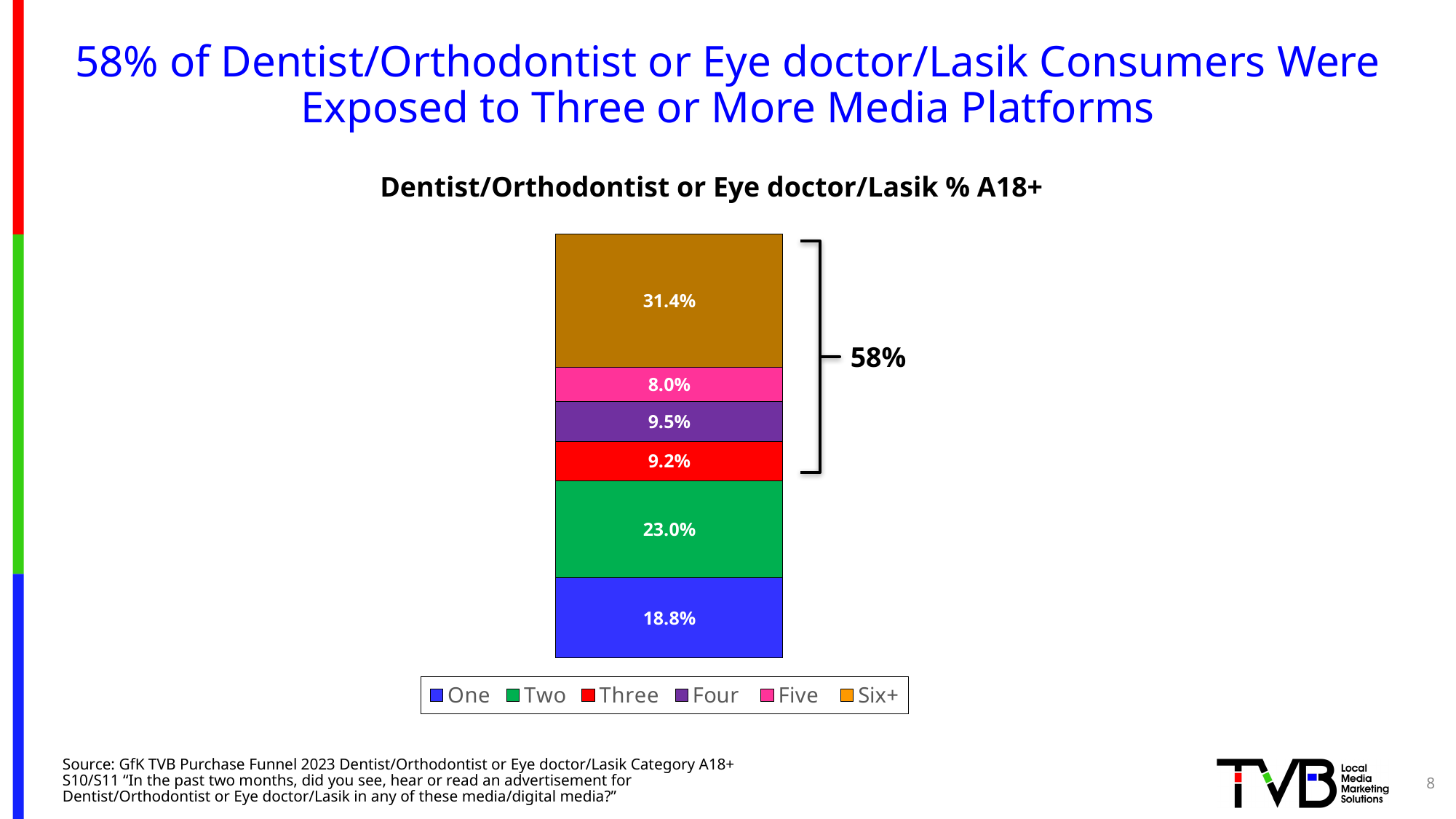
What kind of chart is shown on the slide? Stacked bar chart Which is larger, the value for "Two" or the value for "One"? Two What is the difference between the "Six+" value and the "One" value? 12.6% What percentage of Dentist/Orthodontist or Eye doctor/Lasik consumers were exposed to Six+ media platforms? 31.4% How many series does the legend list? 6 What combined percentage does the bracket on the right of the bar indicate for Three or more platforms? 58% Which segment of the stacked bar has the smallest value? Five What is the value for the "Two" segment of the stacked bar? 23.0% What is the title of the chart? Dentist/Orthodontist or Eye doctor/Lasik % A18+ Which segment of the stacked bar has the largest value? Six+ What is the value for the "Three" segment? 9.2% What is the value for the "Five" segment? 8.0%